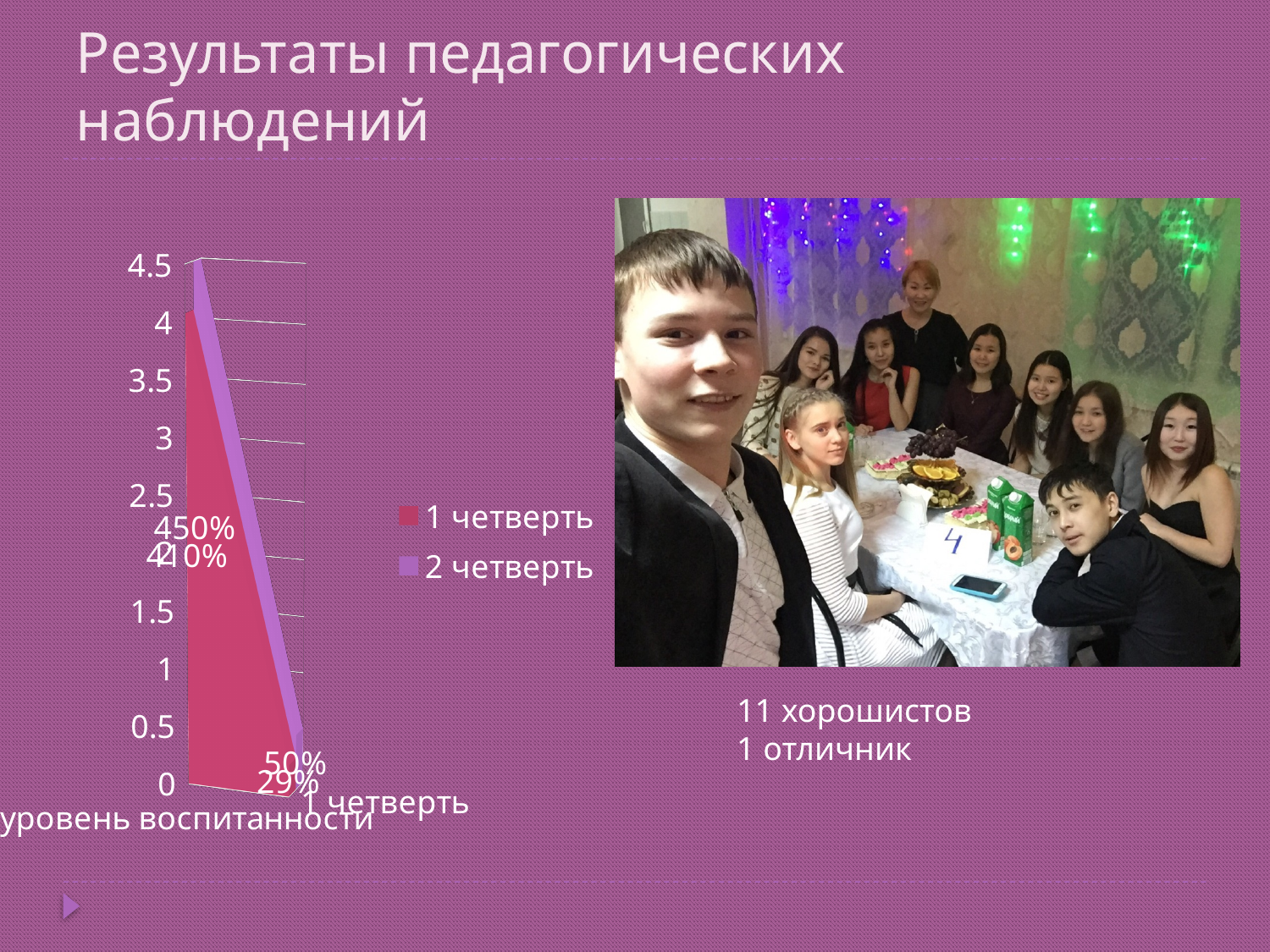
How many categories are shown on the x axis of the chart? 2 Which category has the lowest values on the chart? 1 четверть Is the value for '2 четверть' in the category 'уровень воспитанности' greater or less than 4? greater What are the two series named in the chart legend? 1 четверть and 2 четверть Which category has the highest values on the chart? уровень воспитанности Is the value for '1 четверть' in the category '1 четверть' greater or less than 1? less What kind of chart is shown on the slide? area chart Is the value for '1 четверть' in the category 'уровень воспитанности' greater or less than 3? greater What is the highest value shown on the chart's vertical axis? 4.5 For the category 'уровень воспитанности', which series has the larger value, '1 четверть' or '2 четверть'? 2 четверть How many series does the chart legend list? 2 Do the values fall or rise from the first category to the second category along the x axis? fall